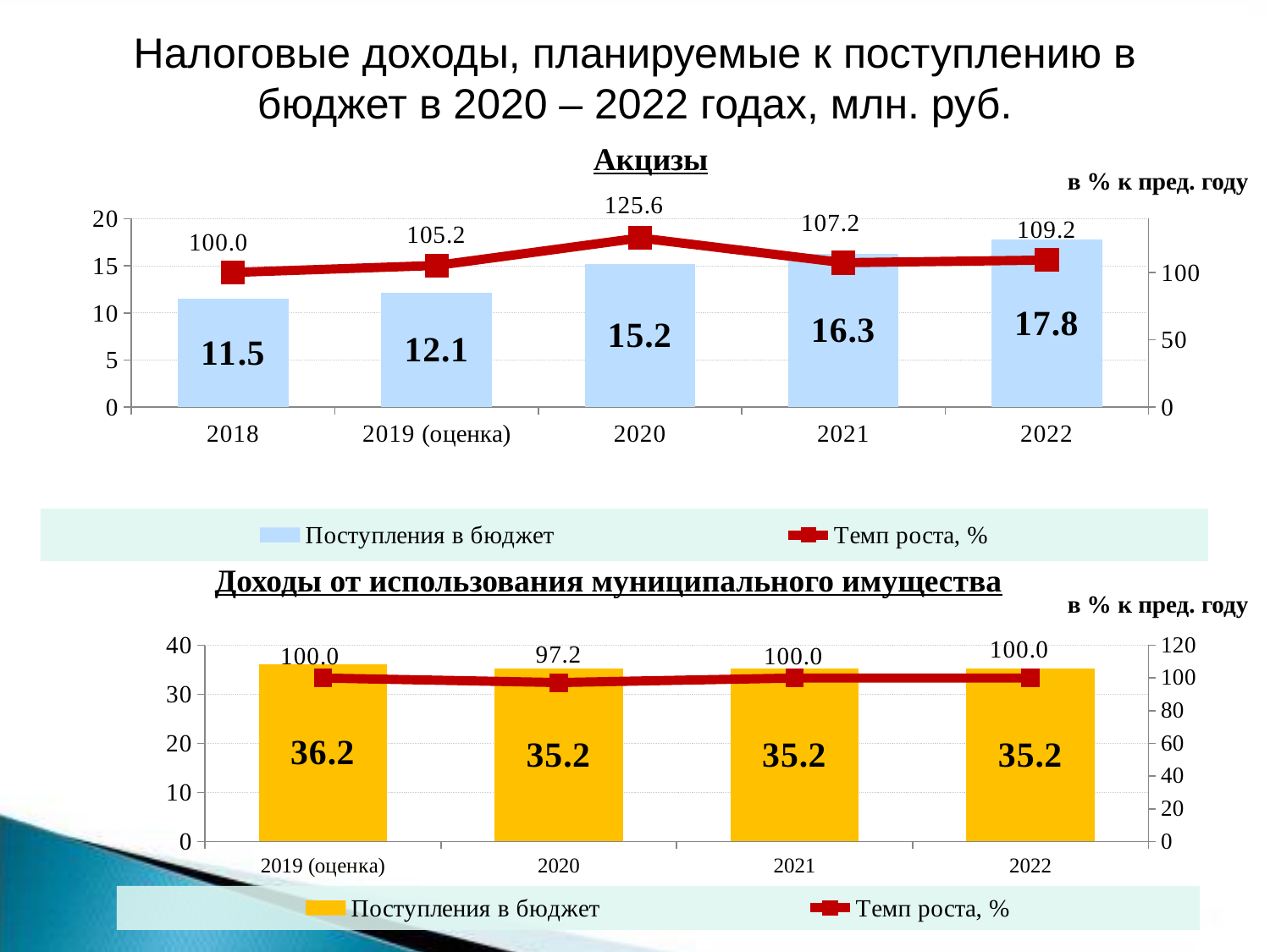
In the "Доходы от использования муниципального имущества" chart, what colour are the "Поступления в бюджет" bars? yellow In the "Доходы от использования муниципального имущества" chart, which year has the highest "Поступления в бюджет" value? 2019 (оценка) In the "Доходы от использования муниципального имущества" chart, what is the "Темп роста, %" value for 2020? 97.2 In the "Акцизы" chart, what is the "Темп роста, %" value for 2020? 125.6 In the "Доходы от использования муниципального имущества" chart, what is the "Поступления в бюджет" value for 2019 (оценка)? 36.2 In the "Доходы от использования муниципального имущества" chart, how many series does the legend list? 2 In the "Акцизы" chart, which year has the highest "Поступления в бюджет" value? 2022 In the "Акцизы" chart, which year has the lowest "Поступления в бюджет" value? 2018 In the "Акцизы" chart, what is the difference between the "Поступления в бюджет" values for 2022 and 2018? 6.3 In the "Акцизы" chart, do the "Поступления в бюджет" values rise or fall from 2018 to 2022? rise In the "Акцизы" chart, how many years are shown on the x axis? 5 In the "Акцизы" chart, what is the value of "Поступления в бюджет" for 2020? 15.2